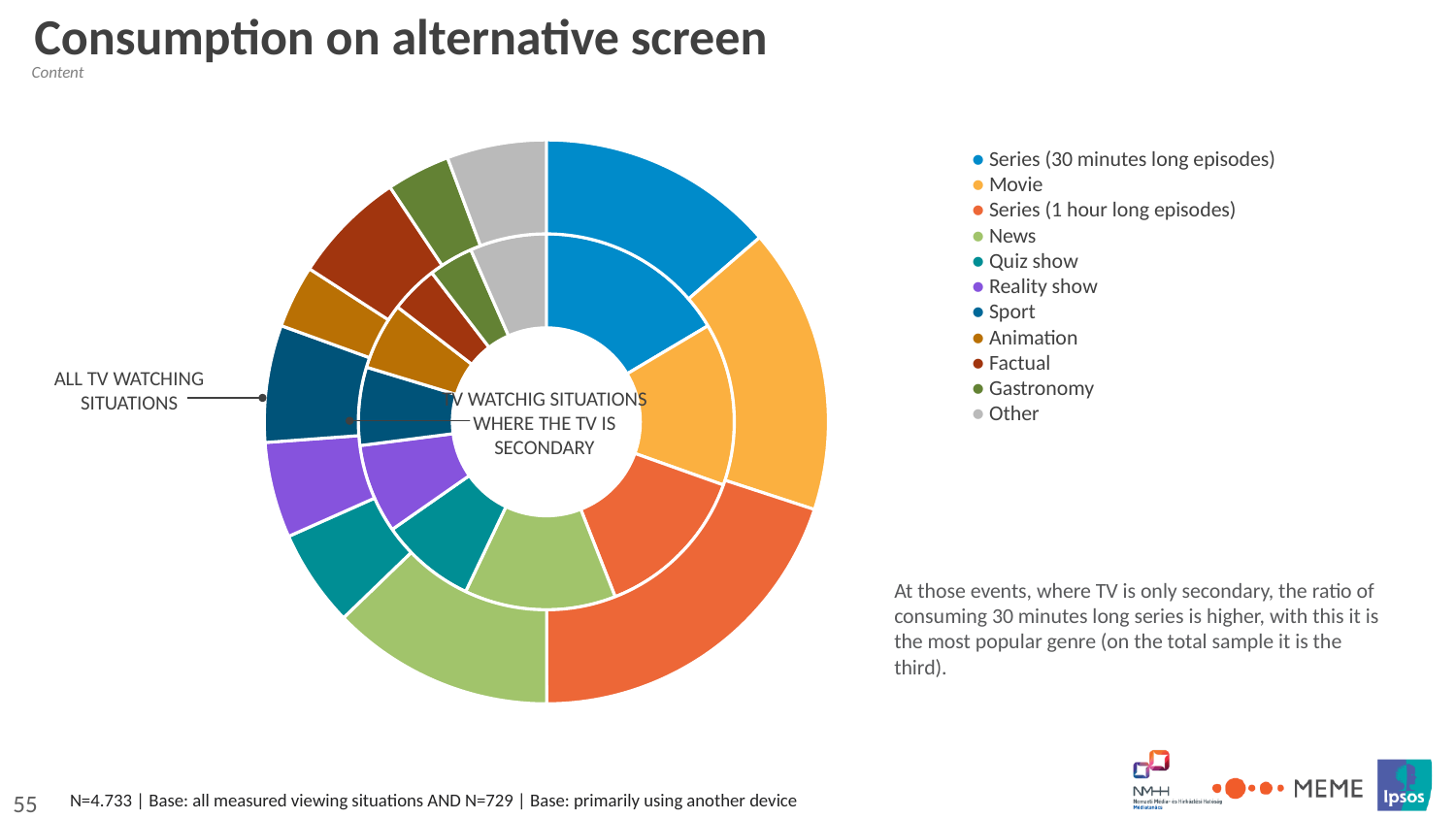
What does the outer ring of the chart represent? ALL TV WATCHING SITUATIONS How many genre categories are plotted in each ring of the chart? 11 What is the title of the slide containing the chart? Consumption on alternative screen In the outer ring (all TV watching situations), which is larger: Movie or Reality show? Movie In the outer ring (all TV watching situations), which is larger: News or Animation? News In the inner ring (TV watching situations where the TV is secondary), which genre has the largest share? Series (30 minutes long episodes) In the inner ring (TV watching situations where the TV is secondary), which is larger: Series (30 minutes long episodes) or Gastronomy? Series (30 minutes long episodes) What kind of chart is shown on the slide? Doughnut chart How many entries does the chart legend list? 11